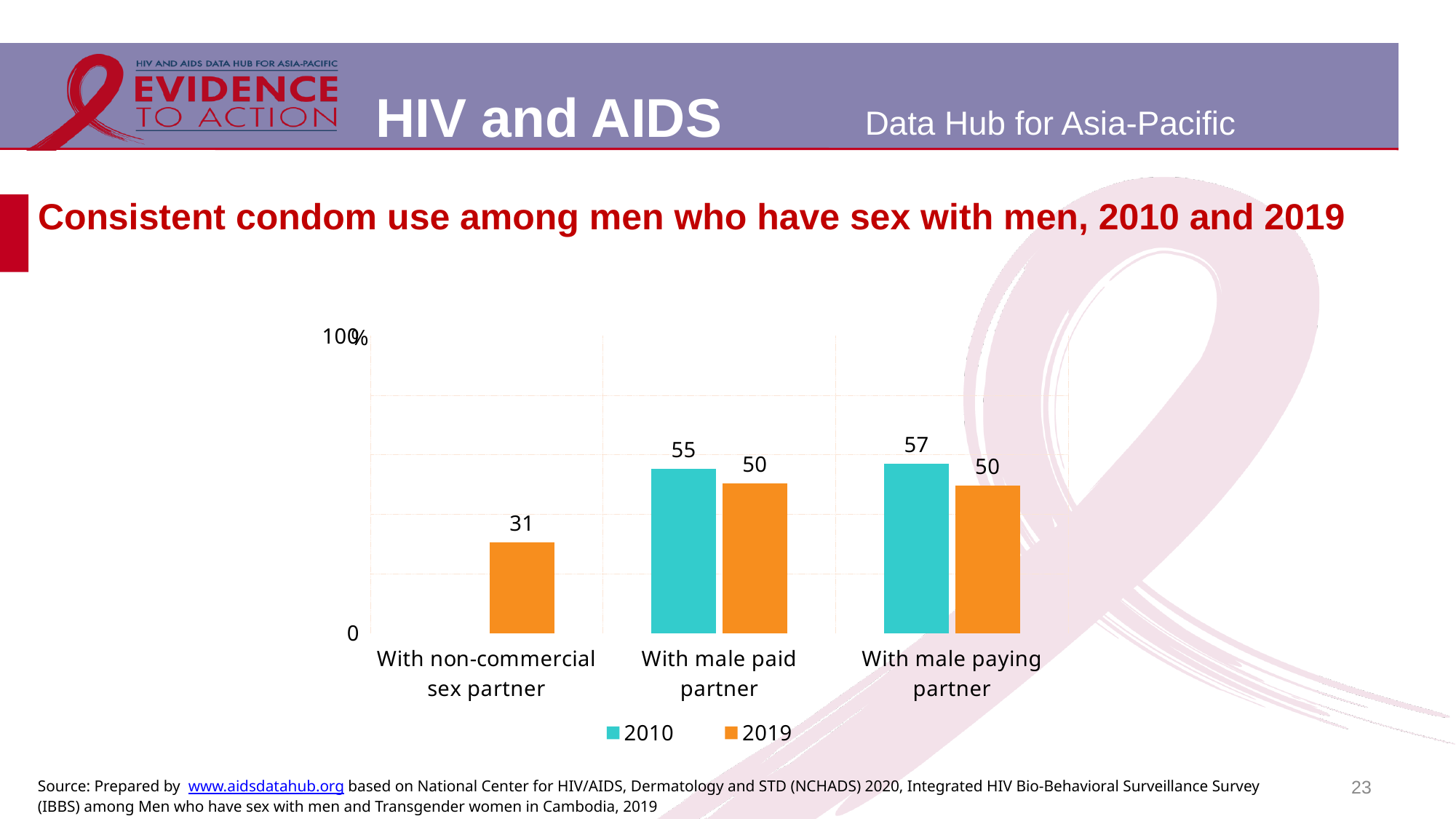
What kind of chart is shown on the slide? Bar chart Which category has the highest 2010 value? With male paying partner What is the 2010 value for consistent condom use with male paying partner? 57 What is the 2019 value for consistent condom use with male paying partner? 50 What is the difference between the 2010 and 2019 values for with male paying partner? 7 How many categories are shown on the x axis? 3 What is the 2010 value for consistent condom use with male paid partner? 55 What is the 2019 value for consistent condom use with non-commercial sex partner? 31 Which is larger for with male paid partner: the 2010 value or the 2019 value? 2010 Which colour represents the 2019 series in the legend? Orange How many series does the legend list? 2 Which category has the lowest 2019 value? With non-commercial sex partner